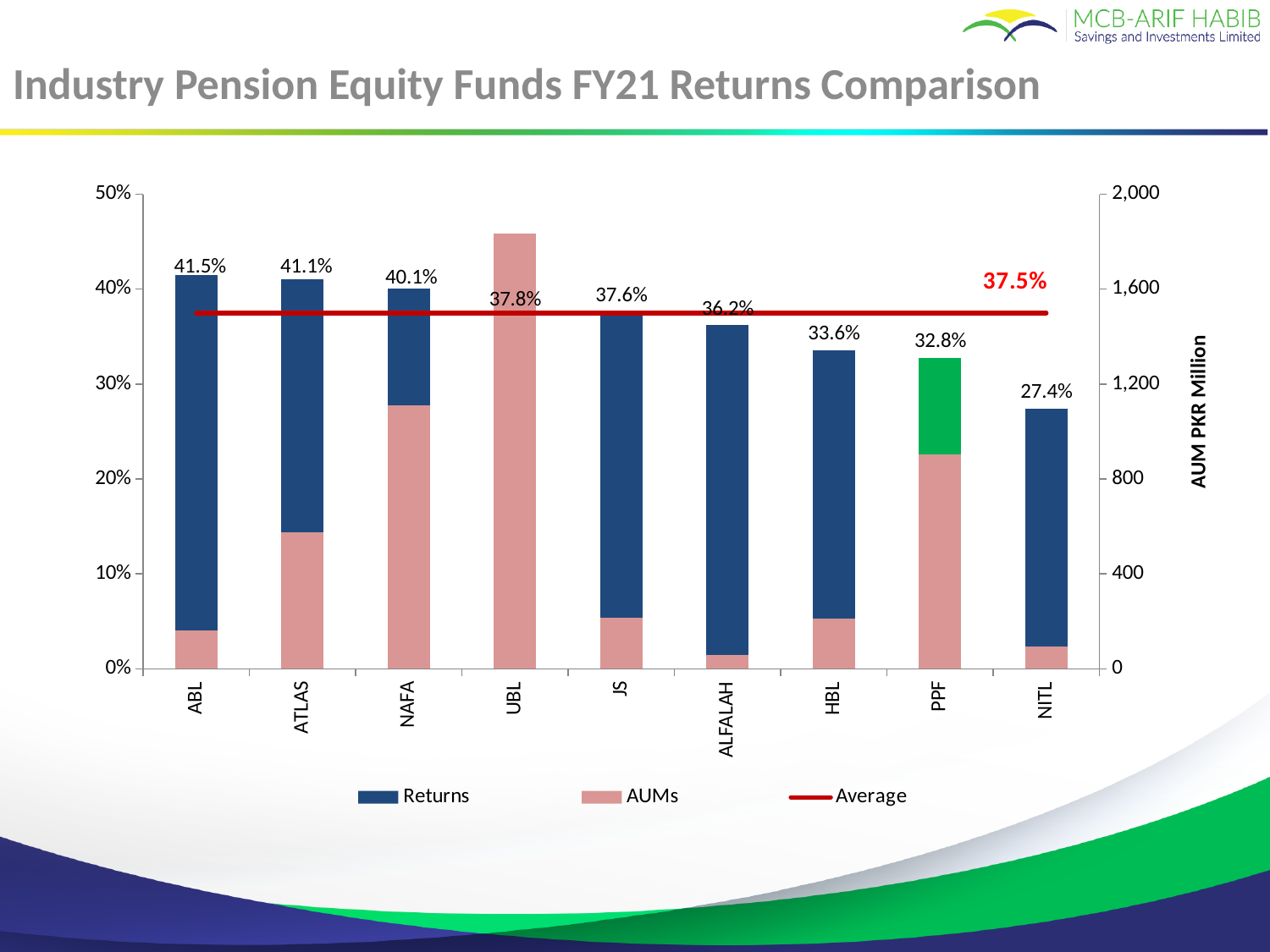
Which has the higher return, HBL or ALFALAH? ALFALAH How many funds are shown on the x axis? 9 What is the FY21 return for ABL? 41.5% Is the AUM value for UBL greater or less than 1,600? greater Which fund has the highest FY21 return? ABL What value does the red Average line represent? 37.5% What is the difference between the returns of ABL and NITL? 14.1% Which fund has the lowest FY21 return? NITL Is the AUM value for ABL greater or less than 400? less What is the FY21 return for PPF? 32.8% What is the FY21 return for NITL? 27.4% How many series does the legend list? 3